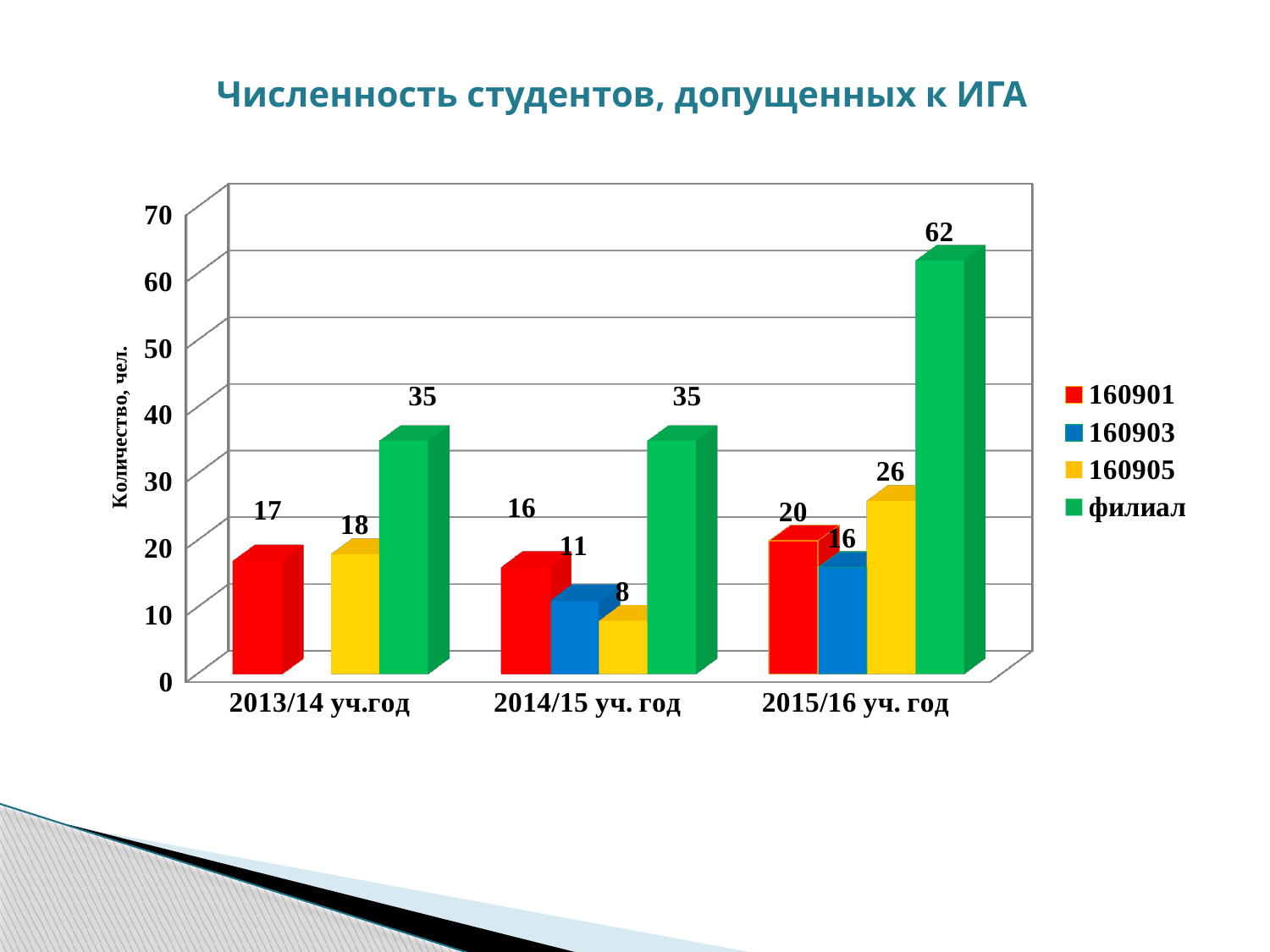
What kind of chart is shown on the slide? Bar chart What is the value for 160903 in 2015/16 уч. год? 16 How many academic years are shown on the x axis? 3 What is the value for филиал in 2015/16 уч. год? 62 How many series does the legend list? 4 In which academic year is the value for 160905 lowest? 2014/15 уч. год Which is larger in 2015/16 уч. год: the value for 160905 or the value for 160901? 160905 What is the title of the chart? Численность студентов, допущенных к ИГА What is the value for 160905 in 2014/15 уч. год? 8 What is the difference between the филиал values for 2015/16 уч. год and 2014/15 уч. год? 27 In which academic year is the value for филиал highest? 2015/16 уч. год What is the value for 160901 in 2013/14 уч.год? 17